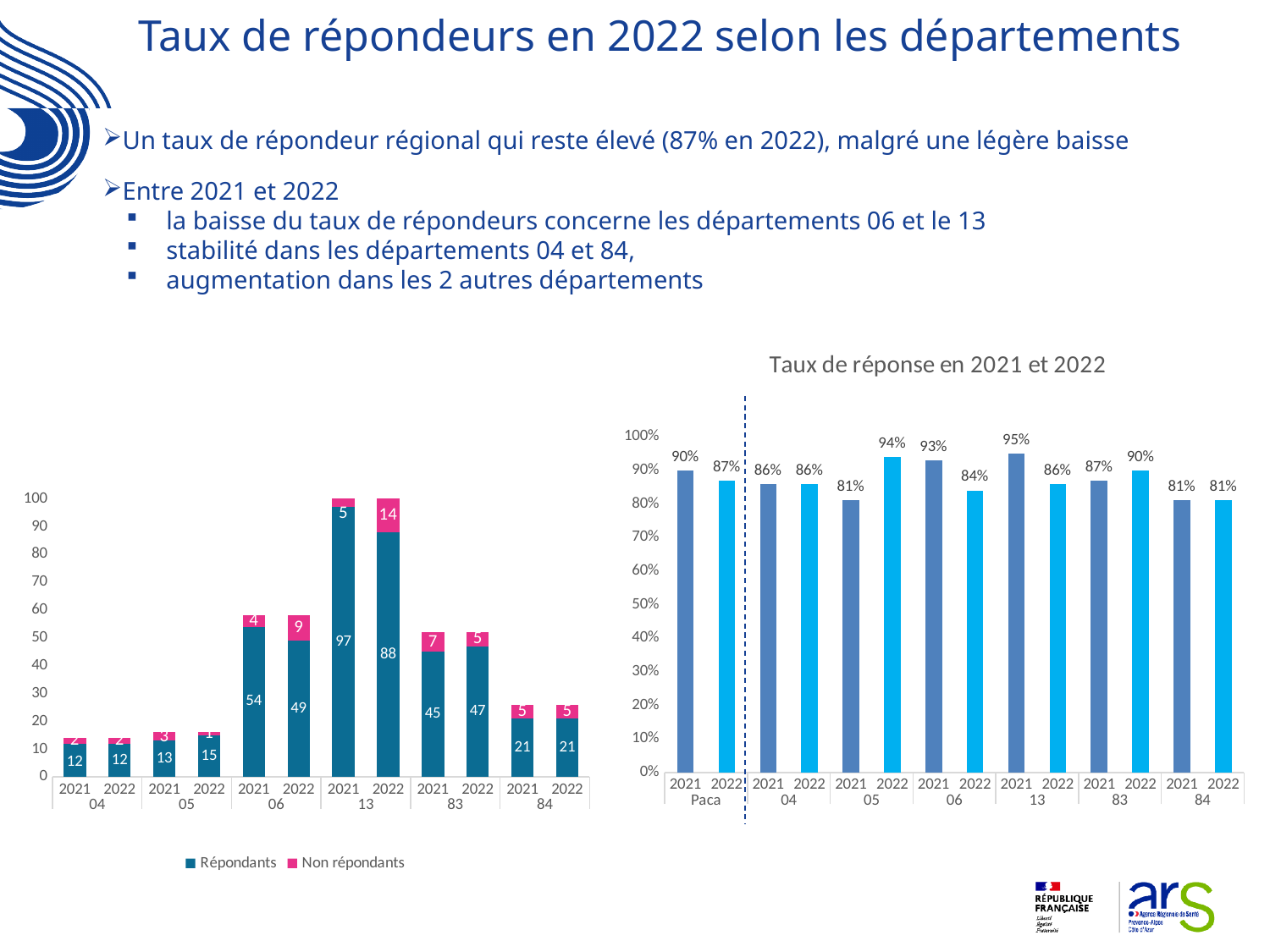
In the stacked bar chart on the left, how many 'Non répondants' are shown for department 13 in 2022? 14 In the chart titled 'Taux de réponse en 2021 et 2022', what is the difference between the 2021 and 2022 response rates for department 06? 9 percentage points In the chart titled 'Taux de réponse en 2021 et 2022', which department and year has the highest response rate? 13 in 2021 (95%) In the stacked bar chart on the left, how many series does the legend list? 2 In the chart titled 'Taux de réponse en 2021 et 2022', does the response rate for department 84 change between 2021 and 2022? No, it stays at 81% In the chart titled 'Taux de réponse en 2021 et 2022', how many bars are plotted? 14 In the stacked bar chart on the left, what is the difference in 'Répondants' between 2021 and 2022 for department 06? 5 In the chart titled 'Taux de réponse en 2021 et 2022', what is the response rate for Paca in 2022? 87% What type of chart is the chart on the left of the slide? Stacked bar chart In the chart titled 'Taux de réponse en 2021 et 2022', is the 2022 response rate for department 83 higher or lower than its 2021 rate? higher In the chart titled 'Taux de réponse en 2021 et 2022', what is the response rate for department 05 in 2022? 94% In the stacked bar chart on the left, how many 'Répondants' are shown for department 13 in 2021? 97